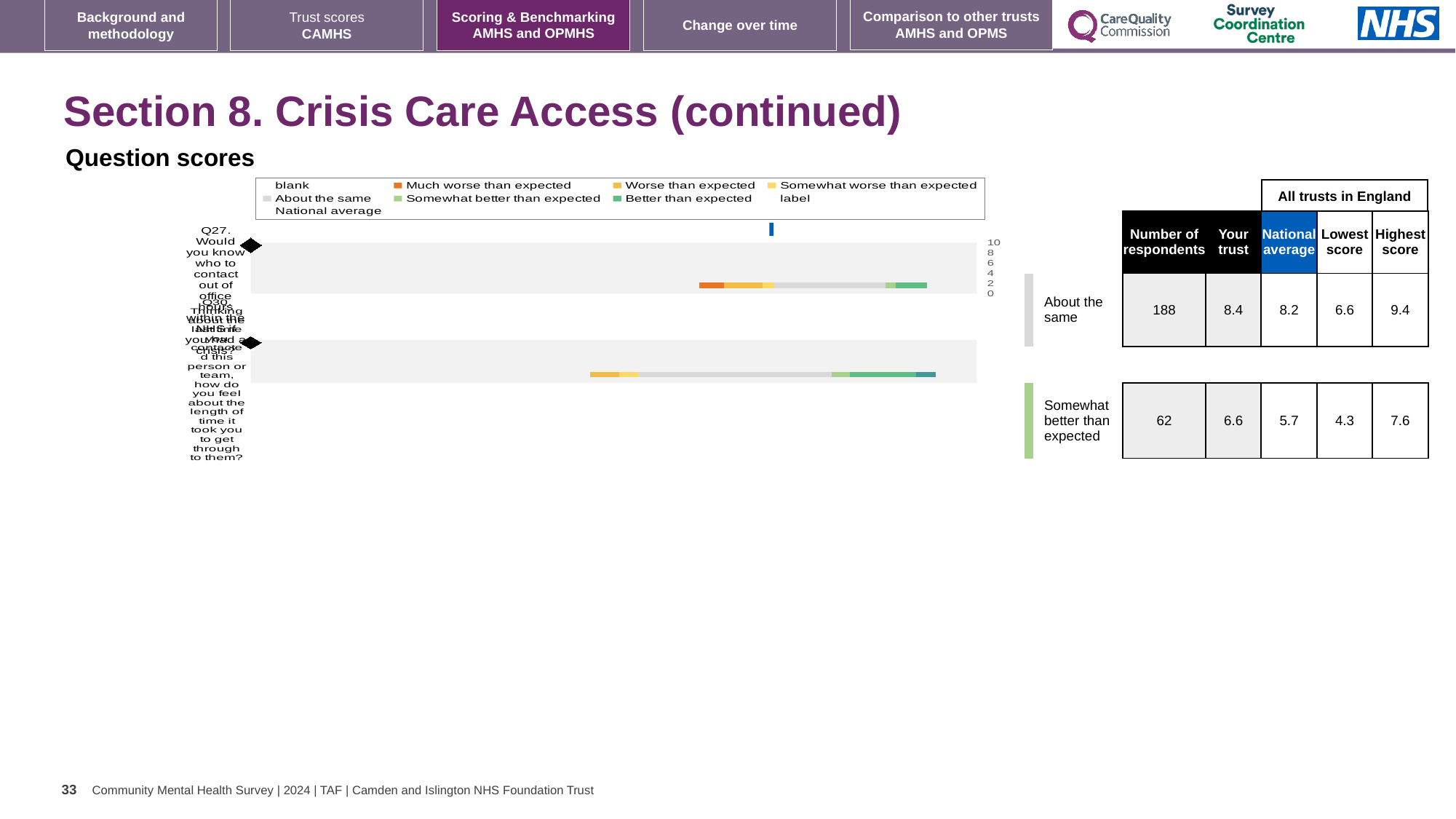
Which question has the higher 'Your trust' score, Q27 or Q30? Q27 In the Question scores chart legend, what colour represents 'National average'? blue Which benchmark category is shown for Q27 in the Question scores chart? About the same What is the 'Your trust' score for Q30 (Somewhat better than expected) in the table beside the chart? 6.6 Which benchmark category is shown for Q30 in the Question scores chart? Somewhat better than expected How many questions (categories) are plotted in the Question scores chart? 2 What is the 'Your trust' score for Q27 (About the same) in the table beside the chart? 8.4 How many respondents answered Q30 according to the table beside the chart? 62 In the Question scores chart legend, what colour represents 'Much worse than expected'? orange What is the difference between the 'Your trust' score and the national average for Q30? 0.9 What kind of chart is shown under 'Question scores'? bar chart What is the national average for Q27 in the table beside the chart? 8.2